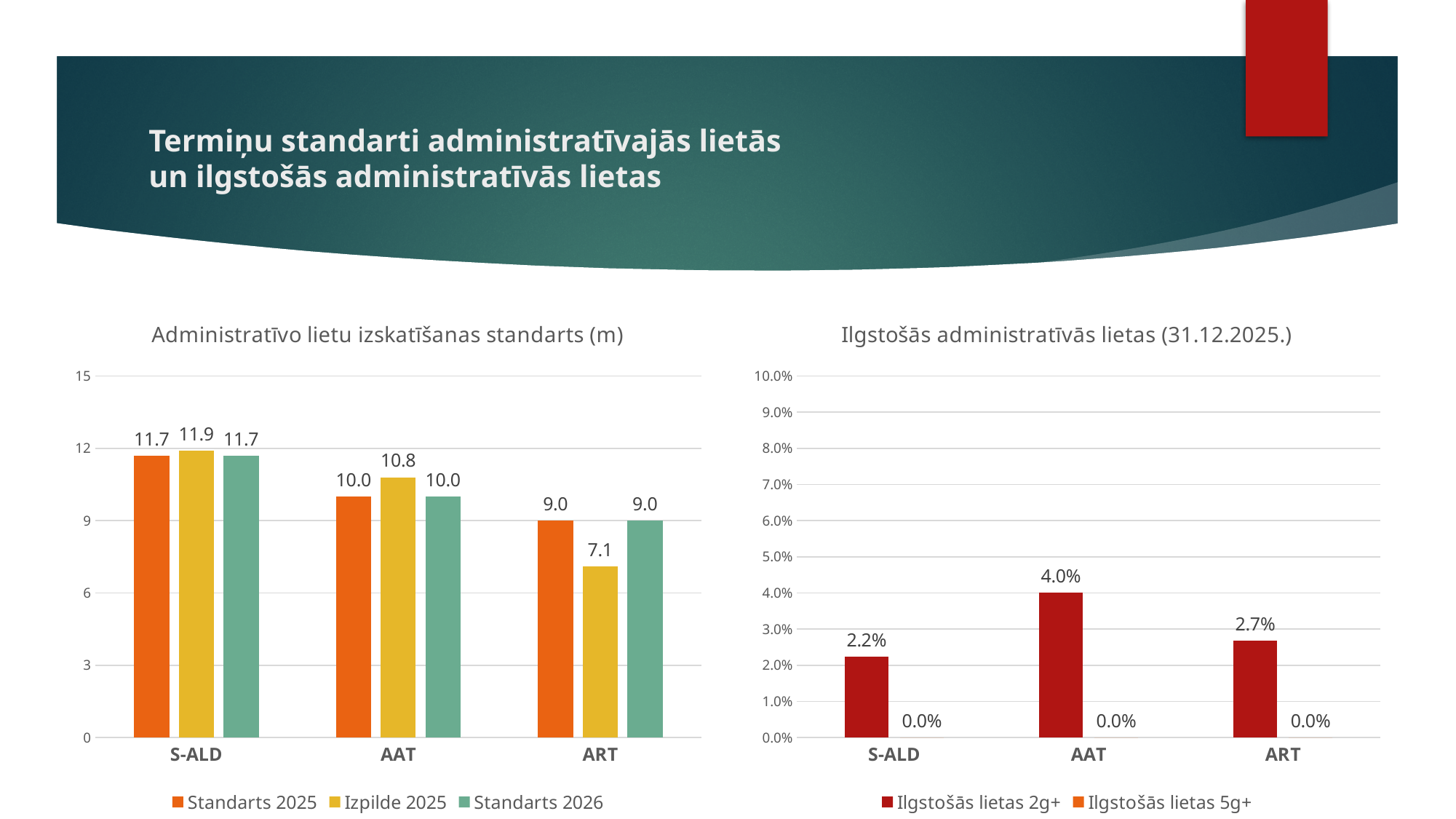
In the chart 'Administratīvo lietu izskatīšanas standarts (m)', what is the difference between Standarts 2025 and Izpilde 2025 for ART? 1.9 In the chart 'Administratīvo lietu izskatīšanas standarts (m)', how many series does the legend list? 3 In the chart 'Administratīvo lietu izskatīšanas standarts (m)', what is the value of Izpilde 2025 for AAT? 10.8 In the chart 'Ilgstošās administratīvās lietas (31.12.2025.)', what is the value of Ilgstošās lietas 2g+ for AAT? 4.0% In the chart 'Administratīvo lietu izskatīšanas standarts (m)', which category has the lowest Izpilde 2025 value? ART In the chart 'Ilgstošās administratīvās lietas (31.12.2025.)', what is the value of Ilgstošās lietas 5g+ for S-ALD? 0.0% In the chart 'Administratīvo lietu izskatīšanas standarts (m)', which category has the highest Izpilde 2025 value? S-ALD In the chart 'Administratīvo lietu izskatīšanas standarts (m)', what is the value of Standarts 2025 for ART? 9.0 In the chart 'Ilgstošās administratīvās lietas (31.12.2025.)', which category has the lowest Ilgstošās lietas 2g+ value? S-ALD What kind of chart is 'Ilgstošās administratīvās lietas (31.12.2025.)'? bar chart In the chart 'Ilgstošās administratīvās lietas (31.12.2025.)', how many categories are shown on the x axis? 3 In the chart 'Ilgstošās administratīvās lietas (31.12.2025.)', is the Ilgstošās lietas 2g+ value for ART larger or smaller than for S-ALD? larger